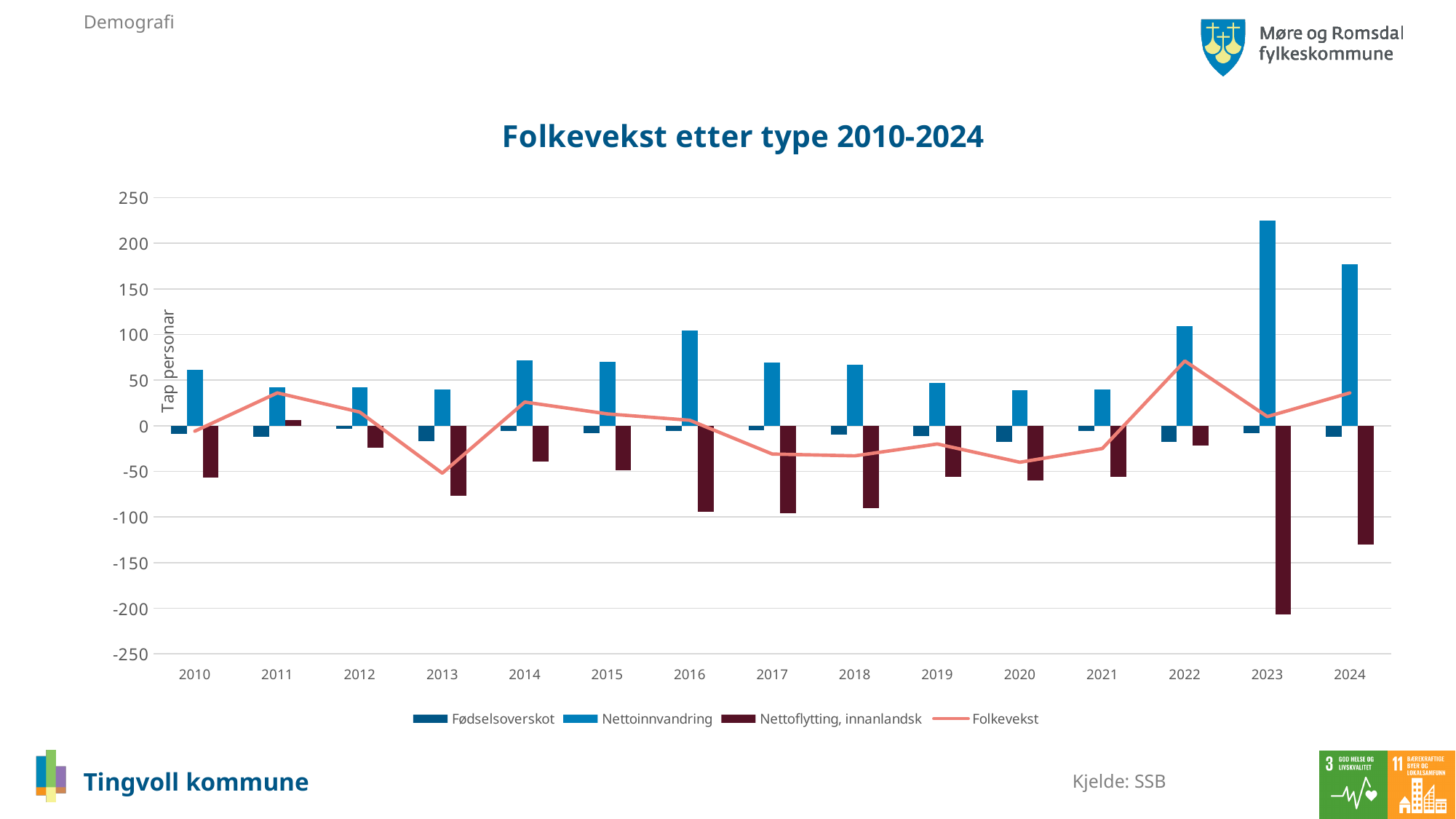
How many years are shown on the x axis? 15 Is the value for Nettoinnvandring in 2023 greater or less than 200? greater In which year does the Folkevekst line reach its lowest point? 2013 Which year has the larger Nettoinnvandring value, 2023 or 2024? 2023 How many series does the legend list? 4 In which year is Nettoinnvandring highest? 2023 In which year is Nettoflytting, innanlandsk lowest (most negative)? 2023 Is the value for Nettoflytting, innanlandsk in 2024 greater or less than -100? less Is the value for Nettoinnvandring in 2024 greater or less than 150? greater What kind of chart is shown on the slide? bar chart with a line What is the title of the chart? Folkevekst etter type 2010-2024 In which year does the Folkevekst line reach its highest point? 2022